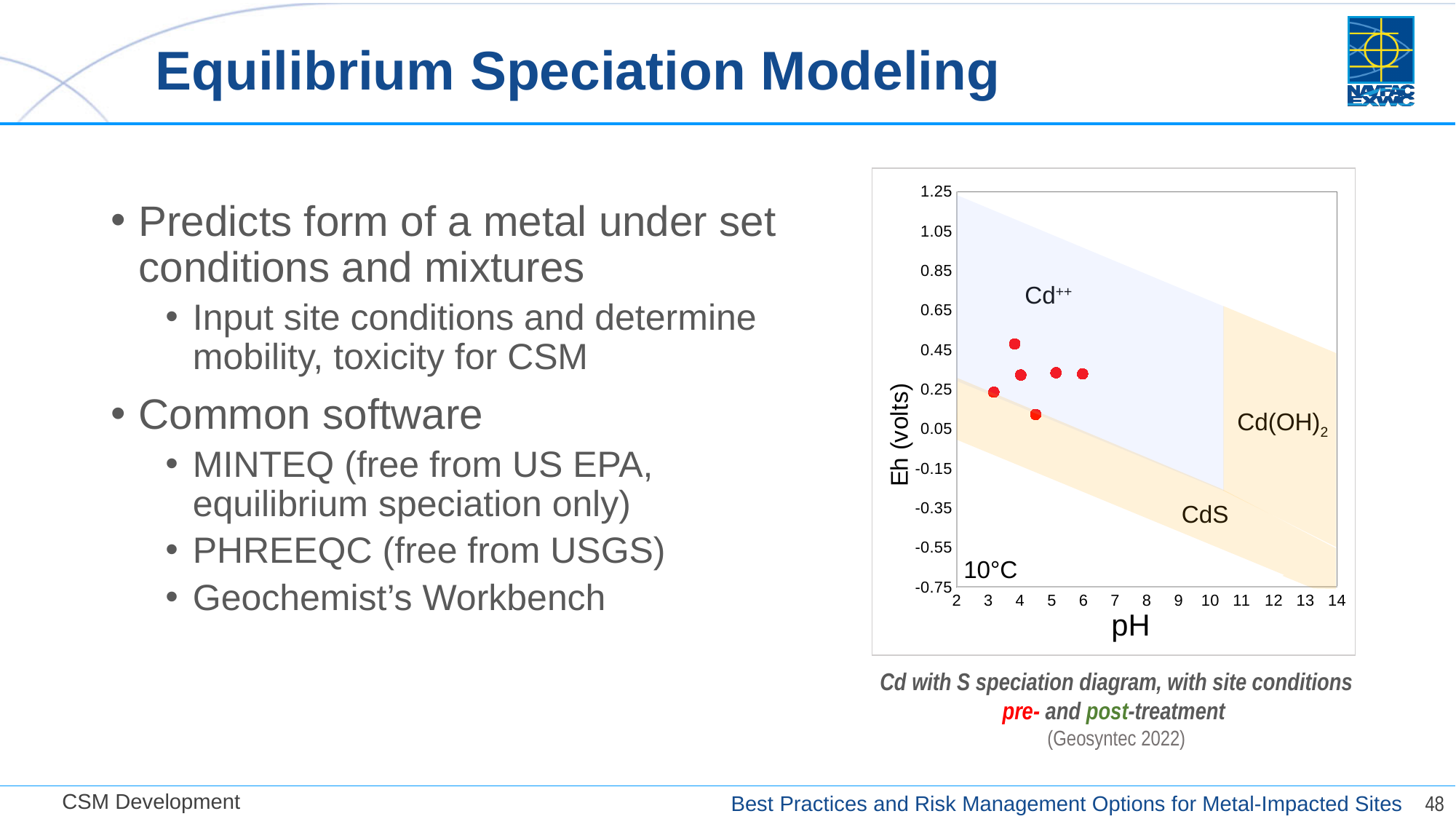
Is the Eh value of the lowest plotted point greater or less than 0.05 volts? greater What temperature is indicated on the chart? 10°C How many red data points are plotted on the chart? 6 What is the label of the x axis of the chart? pH What is the highest pH value shown on the x axis? 14 Is the pH value of the leftmost plotted point greater or less than 4? less What is the lowest Eh value shown on the y axis? -0.75 Is the Eh value of the highest plotted point greater or less than 0.65 volts? less What is the label of the y axis of the chart? Eh (volts) Which labeled stability region do all the plotted points fall in? Cd++ What kind of chart is shown on the slide? scatter chart